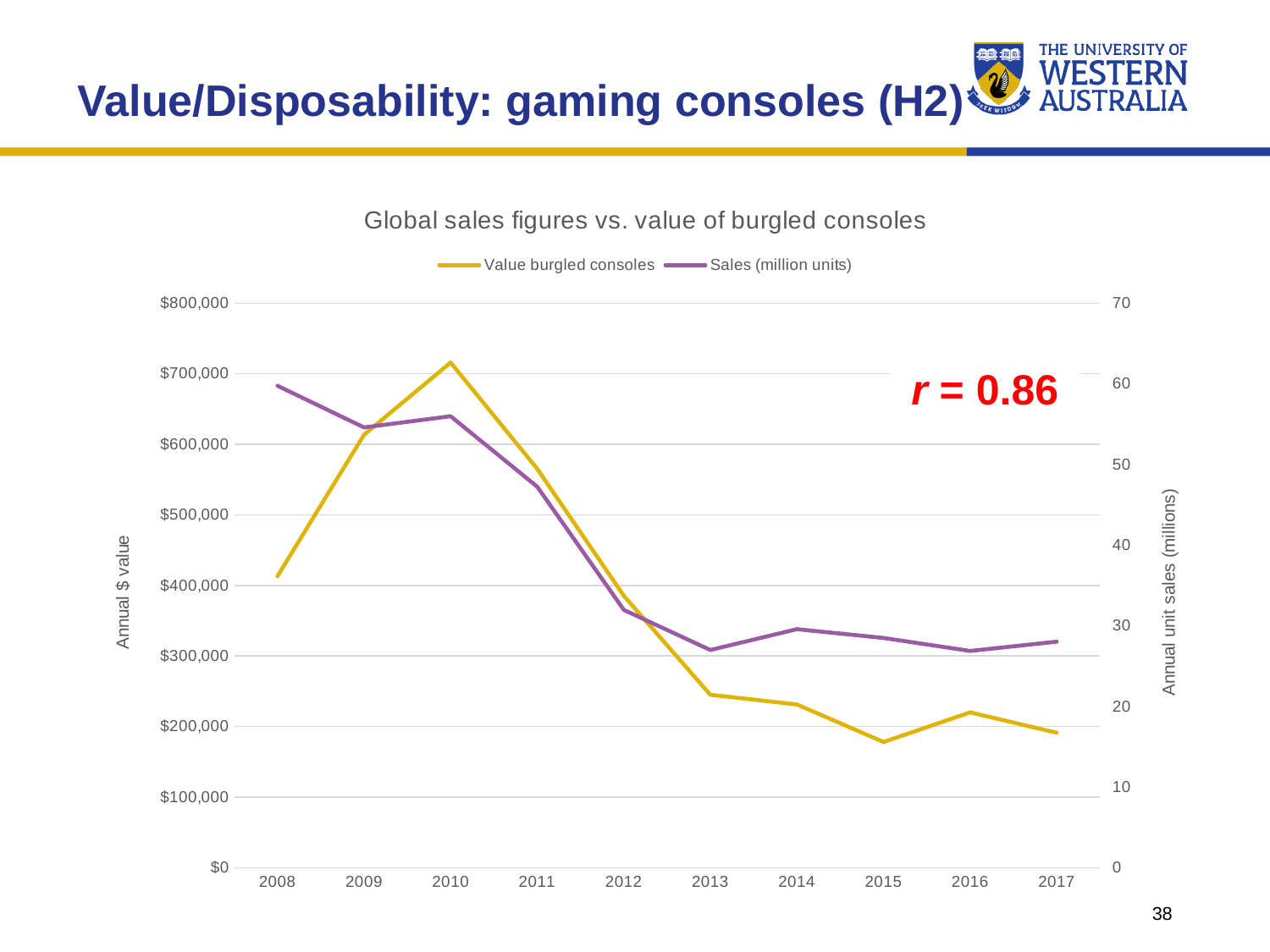
Is the value for Value burgled consoles in 2010 greater or less than $700,000? greater How many years are plotted along the x axis? 10 Is the value for Sales (million units) in 2011 greater or less than 50? less What correlation coefficient r is printed on the chart? 0.86 Does the Value burgled consoles series rise or fall between 2010 and 2015? fall What is the title of the chart? Global sales figures vs. value of burgled consoles What kind of chart is shown on the slide? line chart In which year does the Value burgled consoles series reach its lowest point? 2015 In which year does the Sales (million units) series reach its highest point? 2008 How many series does the legend list? 2 In which year does the Value burgled consoles series reach its highest point? 2010 Is the value for Value burgled consoles in 2015 greater or less than $200,000? less